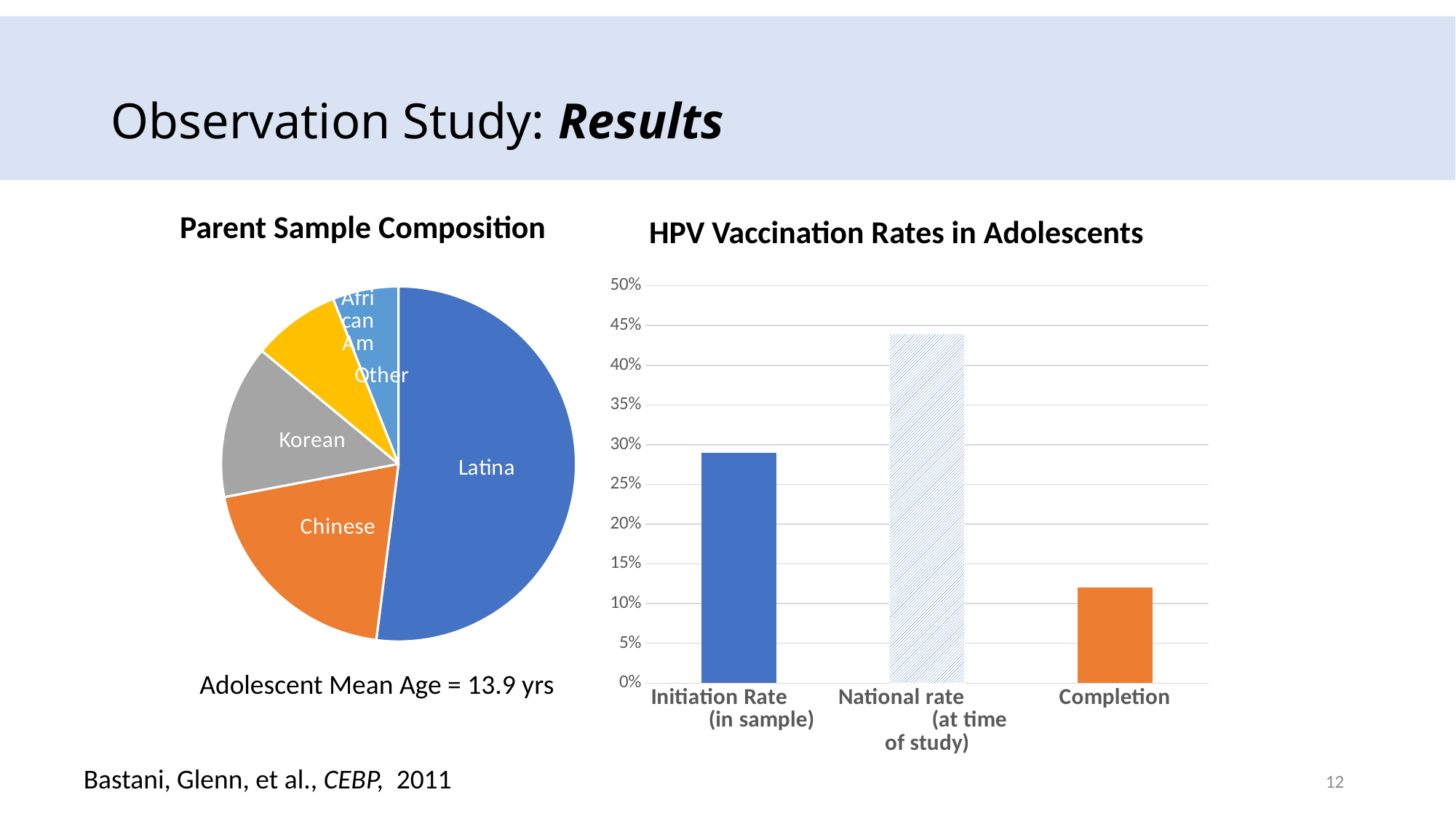
In the HPV Vaccination Rates in Adolescents chart, is the value for Completion greater or less than 15%? less In the HPV Vaccination Rates in Adolescents chart, which category has the lowest value? Completion What kind of chart is the HPV Vaccination Rates in Adolescents chart? bar chart What kind of chart is the Parent Sample Composition chart? pie chart In the HPV Vaccination Rates in Adolescents chart, is the value for National rate (at time of study) greater or less than 40%? greater In the HPV Vaccination Rates in Adolescents chart, which is larger: Initiation Rate (in sample) or Completion? Initiation Rate (in sample) How many slices are in the Parent Sample Composition pie chart? 5 In the Parent Sample Composition chart, which group has the largest slice? Latina In the HPV Vaccination Rates in Adolescents chart, which category has the highest value? National rate (at time of study) In the HPV Vaccination Rates in Adolescents chart, is the value for Initiation Rate (in sample) greater or less than 25%? greater How many categories are shown in the HPV Vaccination Rates in Adolescents chart? 3